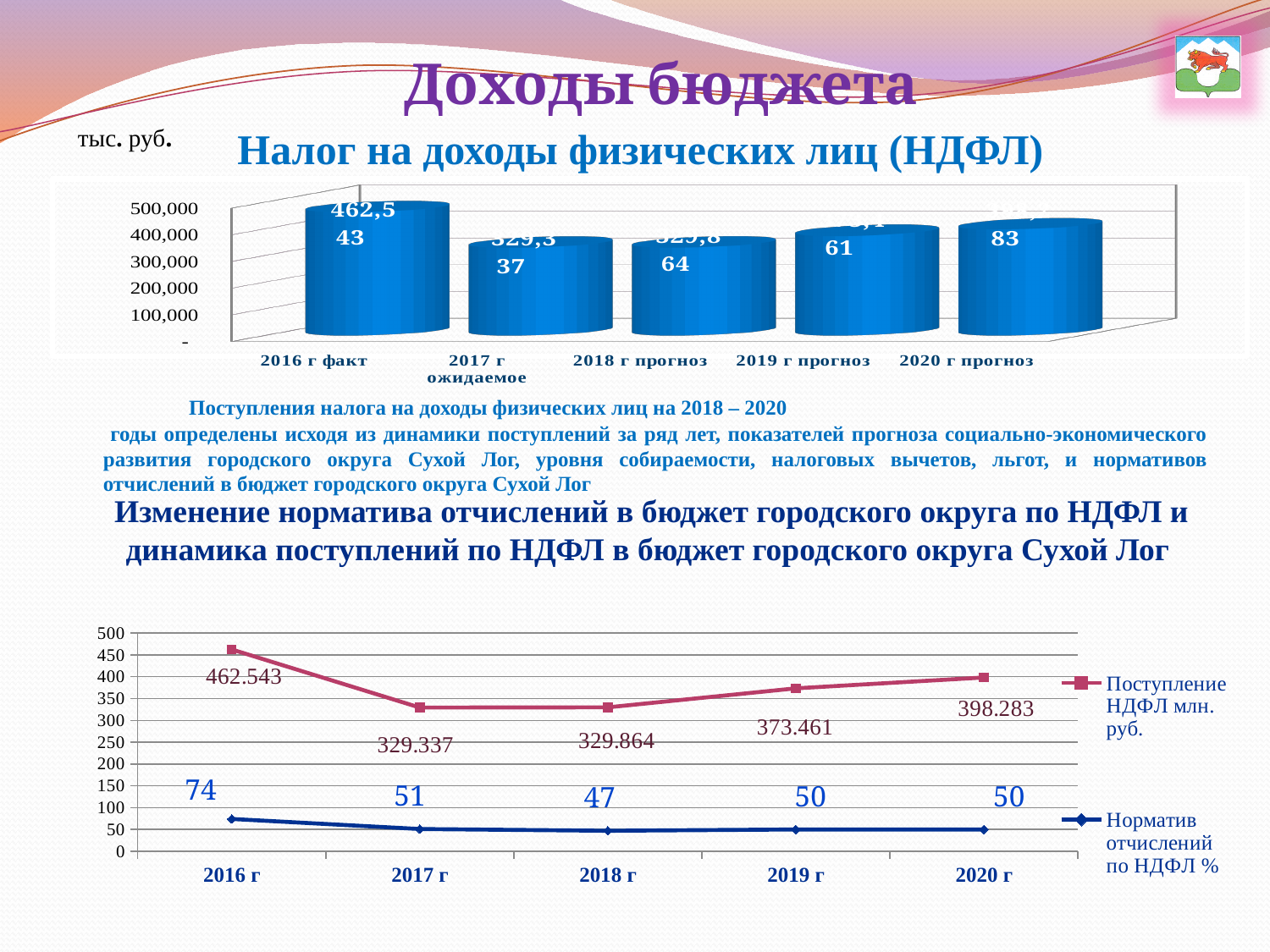
In the bottom line chart, which year has the highest value of Норматив отчислений по НДФЛ %? 2016 г In the bottom line chart, what is the difference between the Норматив отчислений по НДФЛ % values for 2016 г and 2017 г? 23 In the bottom line chart, which is larger: Поступление НДФЛ млн. руб. for 2019 г or for 2020 г? 2020 г In the top chart titled Налог на доходы физических лиц (НДФЛ), is the value for 2017 г ожидаемое greater or less than 400,000? less What kind of chart is the top chart titled Налог на доходы физических лиц (НДФЛ)? bar chart How many series does the legend of the bottom line chart list? 2 In the bottom line chart, which year has the lowest value of Поступление НДФЛ млн. руб.? 2017 г How many years are plotted on the x axis of the bottom line chart? 5 In the bottom line chart, what is the value of Поступление НДФЛ млн. руб. for 2016 г? 462.543 In the bottom line chart, what is the value of Поступление НДФЛ млн. руб. for 2020 г? 398.283 In the top chart titled Налог на доходы физических лиц (НДФЛ), which category has the highest value? 2016 г факт In the bottom line chart, what is the value of Норматив отчислений по НДФЛ % for 2018 г? 47